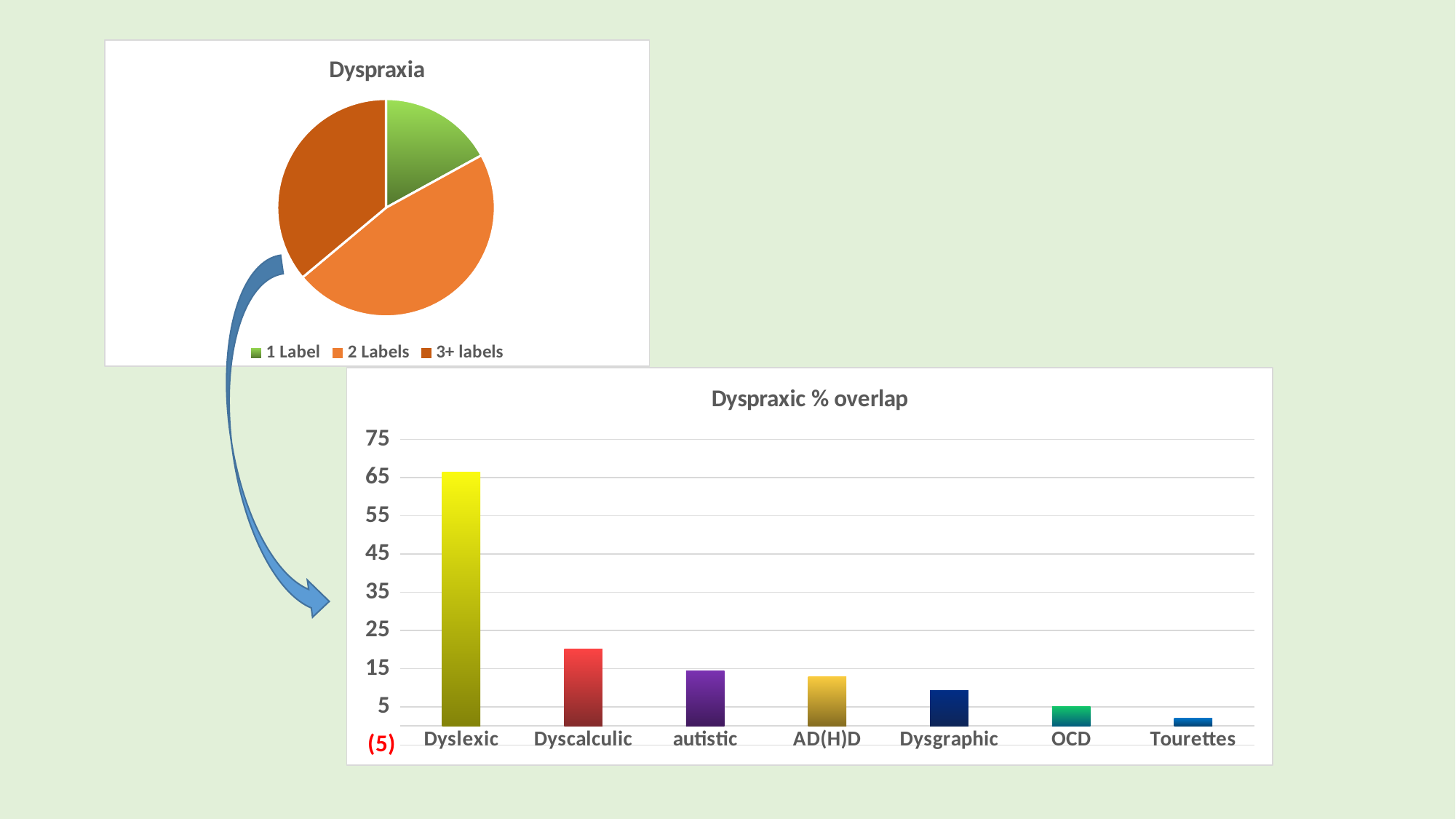
In the "Dyspraxic % overlap" chart, which is larger, the value for Dyscalculic or the value for Dysgraphic? Dyscalculic In the "Dyspraxic % overlap" chart, how many categories are shown on the x axis? 7 What kind of chart is the "Dyspraxic % overlap" chart? bar chart In the "Dyspraxic % overlap" chart, is the value for Tourettes greater or less than 5? less In the "Dyspraxic % overlap" chart, is the value for Dyscalculic greater or less than 25? less In the "Dyspraxic % overlap" chart, which category has the lowest bar? Tourettes In the "Dyspraxic % overlap" chart, is the value for Dyslexic greater or less than 55? greater In the "Dyspraxia" pie chart, which slice is the largest? 2 Labels In the "Dyspraxia" pie chart, which slice is the smallest? 1 Label What kind of chart is the "Dyspraxia" chart at the top left? pie chart In the "Dyspraxia" pie chart, how many entries does the legend list? 3 In the "Dyspraxic % overlap" chart, which category has the highest bar? Dyslexic